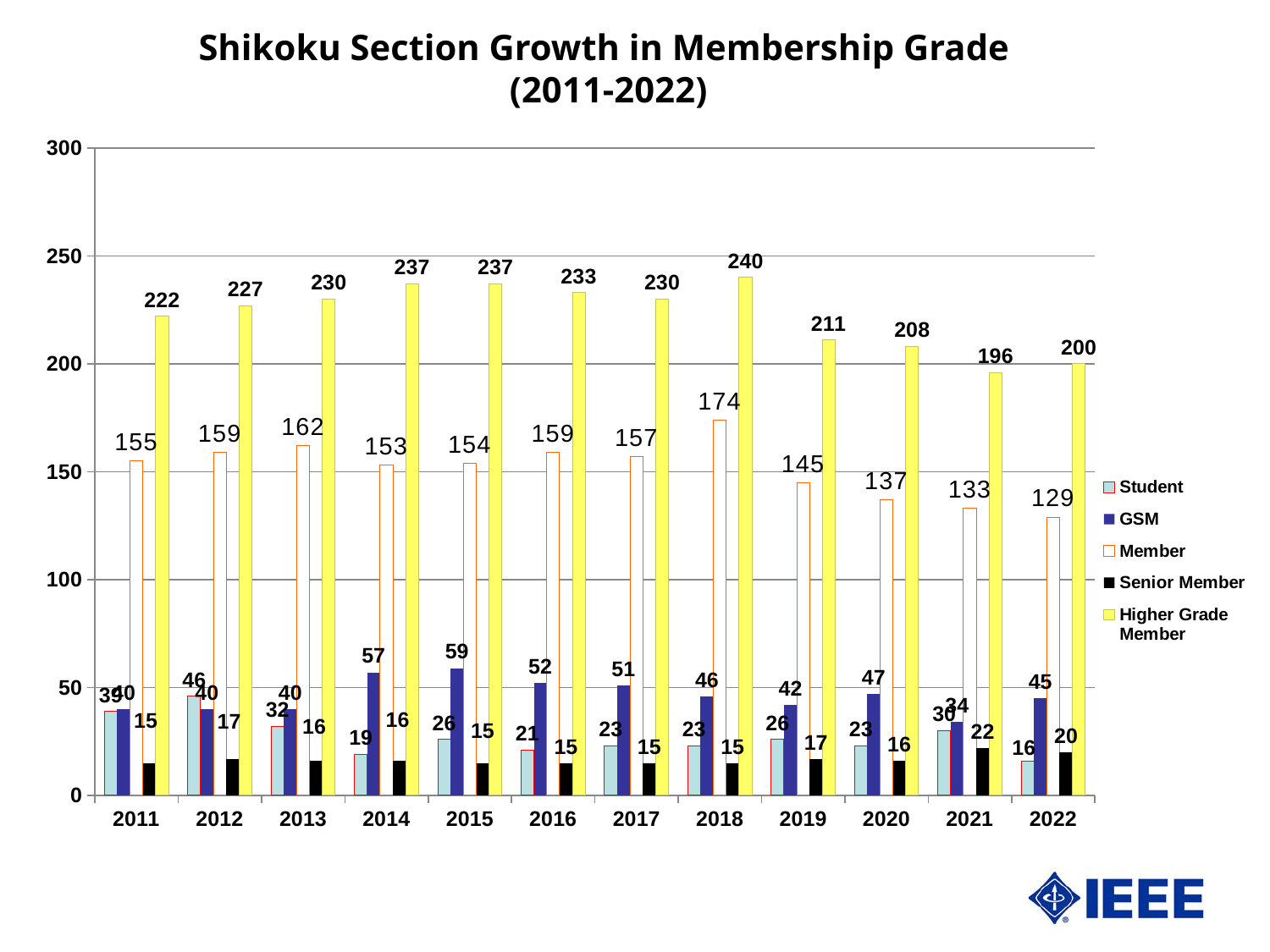
What is the difference between the Higher Grade Member values in 2011 and 2022? 22 Is the value for Member in 2020 greater or less than 150? less In which year is the Member value lowest? 2022 What is the value for Member in 2018? 174 How many years are shown on the x axis? 12 In which year is the Higher Grade Member value highest? 2018 In which year is the GSM value highest? 2015 What is the value for Higher Grade Member in 2018? 240 What kind of chart is shown on the slide? bar chart How many series does the legend list? 5 What is the value for Senior Member in 2021? 22 Which is larger, the Student value in 2012 or the Student value in 2022? 2012